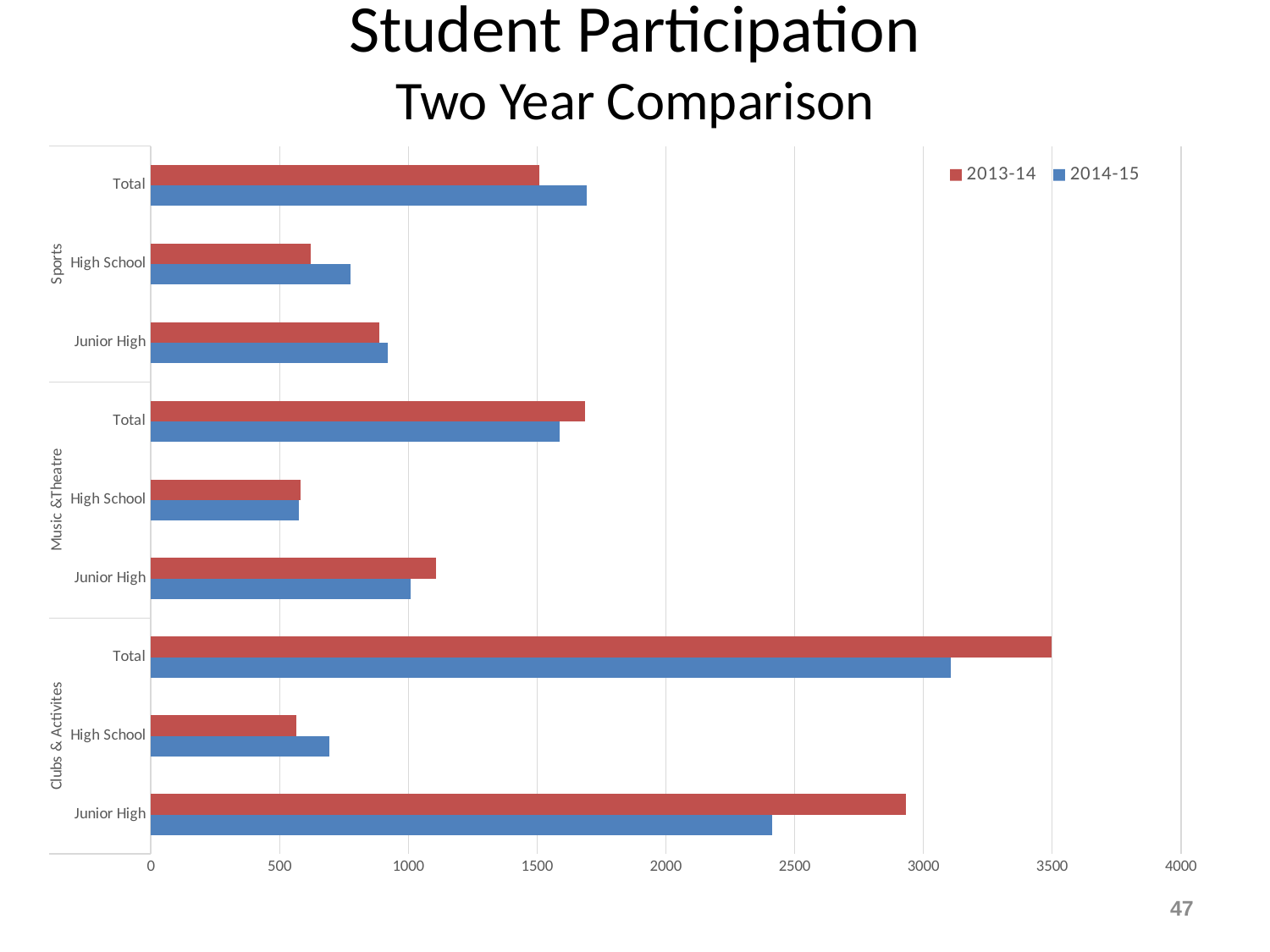
What kind of chart is shown on the slide? bar chart Is the 2013-14 value for Music & Theatre Junior High greater or less than 1000? greater How many category groups (Sports, Music & Theatre, Clubs & Activities) are shown on the vertical axis? 3 Which category has the longest bar for 2013-14? Clubs & Activities Total For Clubs & Activities Junior High, which year has the larger value, 2013-14 or 2014-15? 2013-14 Is the 2014-15 value for Clubs & Activities Junior High greater or less than 2500? less What are the two series named in the legend? 2013-14 and 2014-15 For Sports High School, which year has the larger value, 2013-14 or 2014-15? 2014-15 Which category has the shortest bar for 2014-15? Music & Theatre High School How many series does the legend list? 2 Is the 2013-14 value for Clubs & Activities High School greater or less than 1000? less